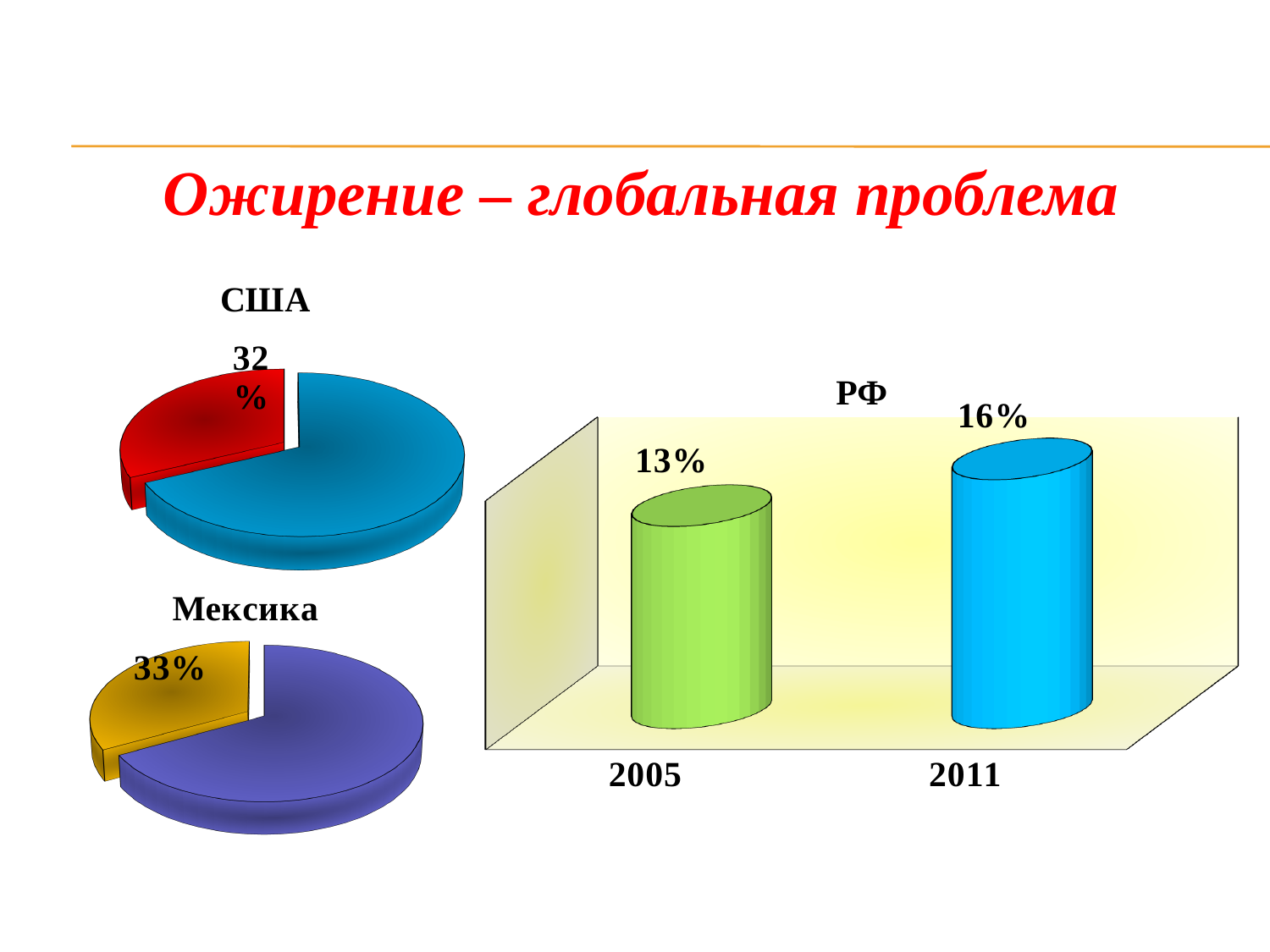
How many years are shown in the РФ bar chart? 2 In the Мексика pie chart, what share does the yellow slice represent? 33% In the США pie chart, what share does the red slice represent? 32% Which is larger: the labelled slice in the Мексика pie chart or the labelled slice in the США pie chart? Мексика In the РФ bar chart, what is the difference between the 2011 and 2005 values? 3% In the РФ bar chart, what is the value for 2005? 13% In the РФ bar chart, which year has the higher value? 2011 What kind of chart is the РФ chart? bar chart What kind of chart is the США chart? pie chart In the РФ bar chart, which year has the lower value? 2005 In the РФ bar chart, do the values rise or fall from 2005 to 2011? rise In the РФ bar chart, what is the value for 2011? 16%